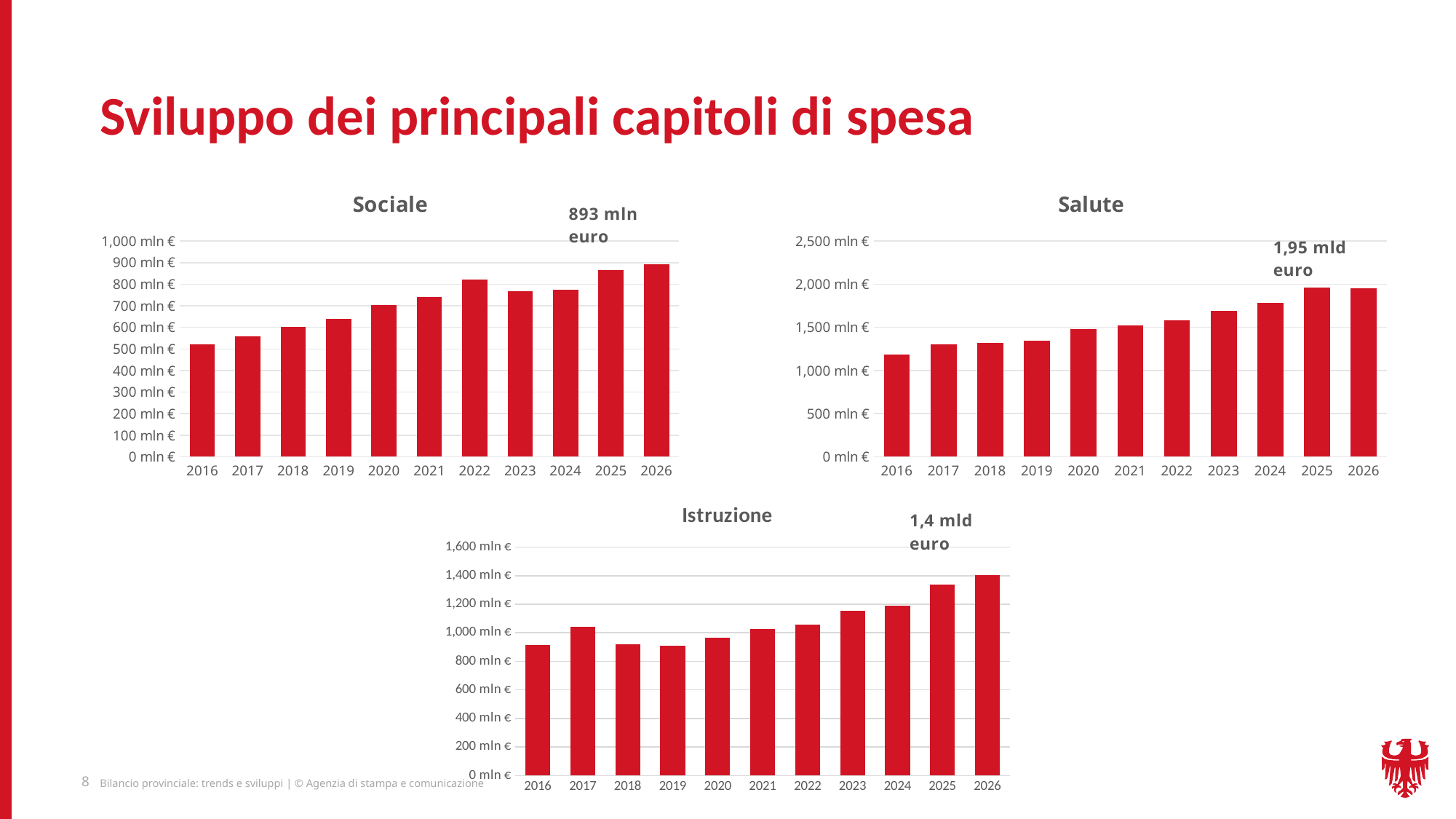
In the Istruzione chart, is the value for 2025 greater or less than 1,200 mln €? greater In the Sociale chart, what value is annotated for 2026? 893 mln euro In the Istruzione chart, what value is annotated for 2026? 1,4 mld euro In the Salute chart, what value is annotated for 2025? 1,95 mld euro In the Salute chart, is the value for 2023 greater or less than 1,500 mln €? greater How many years are shown on the x axis of the Sociale chart? 11 In the Sociale chart, which year has the lowest value? 2016 What kind of chart is the Istruzione chart? bar chart In the Salute chart, which year has the lowest value? 2016 In the Istruzione chart, which year has the highest value? 2026 In the Sociale chart, is the value for 2016 greater or less than 600 mln €? less In the Salute chart, which is larger, the value for 2016 or the value for 2024? 2024